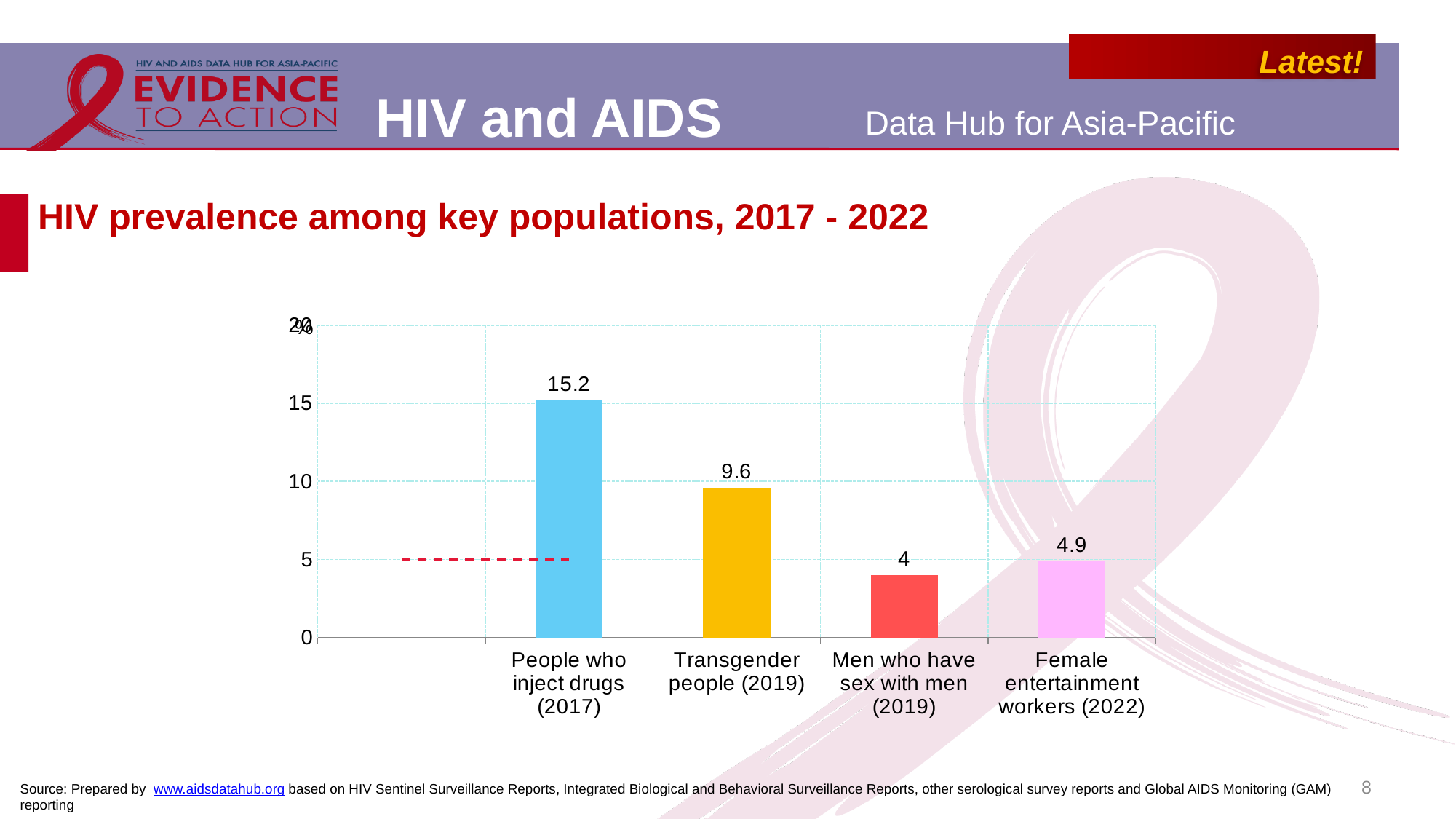
Which key population has the lowest HIV prevalence? Men who have sex with men (2019) Which has a higher HIV prevalence: female entertainment workers (2022) or men who have sex with men (2019)? Female entertainment workers (2022) Is the HIV prevalence for transgender people (2019) greater or less than 10? less What is the title of the chart? HIV prevalence among key populations, 2017 - 2022 How many key populations are shown in the chart? 4 What type of chart is used to show HIV prevalence among key populations? Bar chart What is the HIV prevalence among transgender people (2019)? 9.6 What is the HIV prevalence among men who have sex with men (2019)? 4 What is the HIV prevalence among people who inject drugs (2017)? 15.2 Which key population has the highest HIV prevalence? People who inject drugs (2017) What is the HIV prevalence among female entertainment workers (2022)? 4.9 What is the difference in HIV prevalence between people who inject drugs (2017) and transgender people (2019)? 5.6